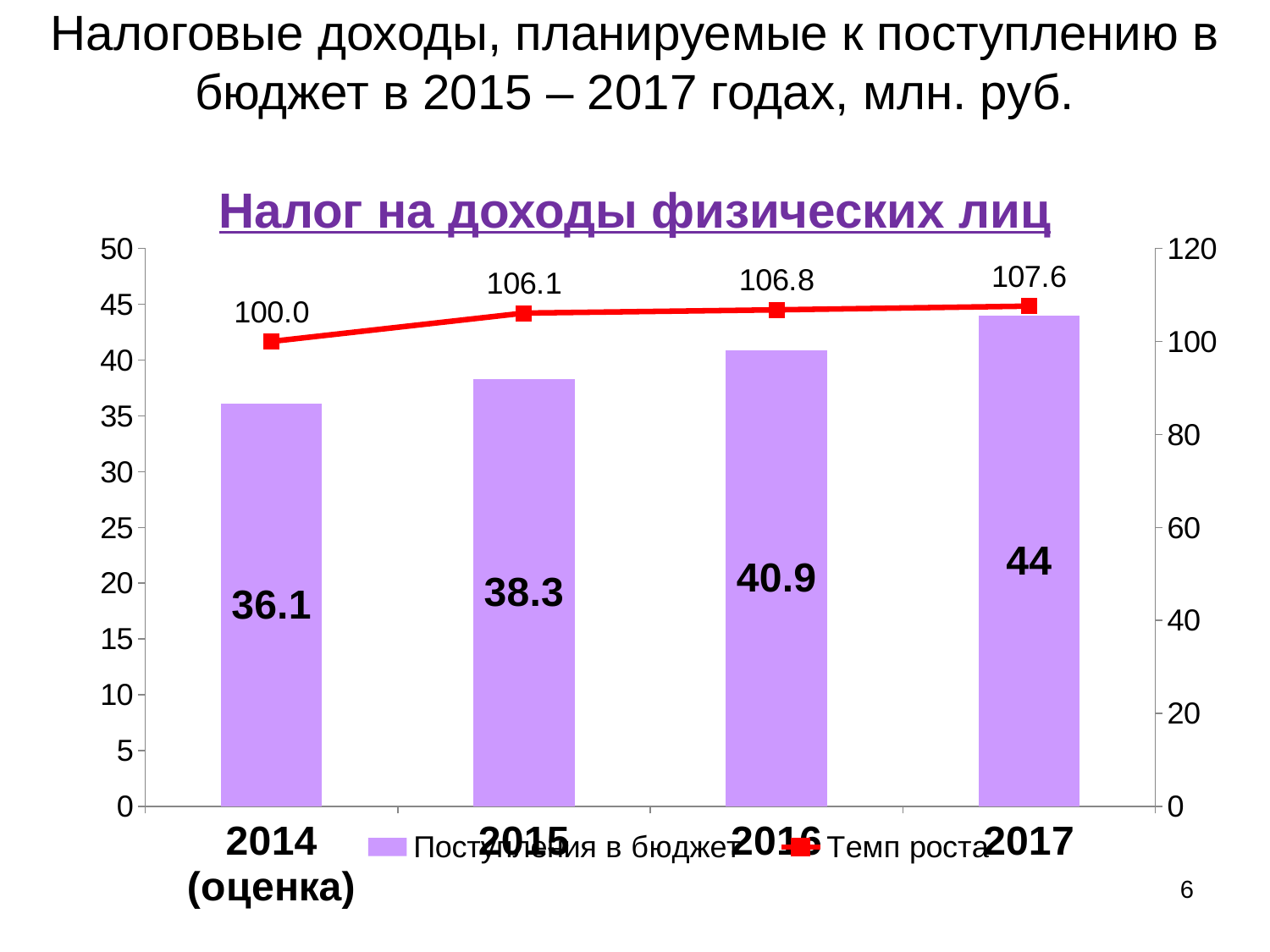
Which year has the lowest 'Поступления в бюджет' value? 2014 (оценка) How many years are shown on the x axis? 4 What is the value of 'Поступления в бюджет' for 2017? 44 What is the difference between the 'Поступления в бюджет' values for 2017 and 2014 (оценка)? 7.9 What is the value of 'Поступления в бюджет' for 2015? 38.3 What is the title of the chart? Налог на доходы физических лиц Do the 'Поступления в бюджет' values rise or fall from 2014 to 2017? rise Which is larger, the 'Поступления в бюджет' value for 2016 or for 2015? 2016 What is the 'Темп роста' value for 2016? 106.8 Which year has the highest 'Поступления в бюджет' value? 2017 How many series does the legend list? 2 What is the 'Темп роста' value for 2014 (оценка)? 100.0